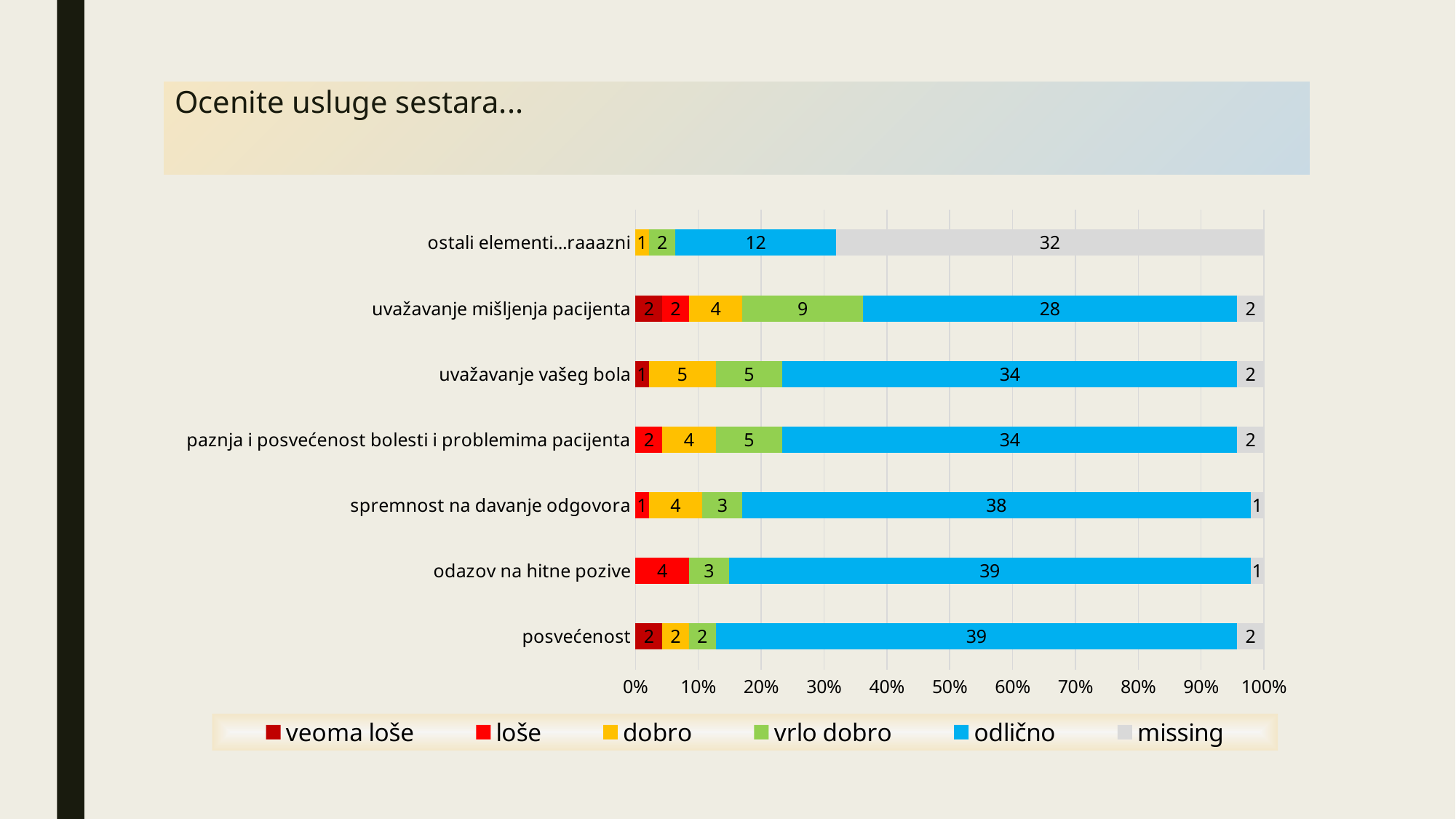
How many series does the legend list? 6 What is the 'odlično' value for 'uvažavanje mišljenja pacijenta'? 28 What kind of chart is shown on the slide? stacked bar chart Which category has the lowest 'odlično' value? ostali elementi...raaazni Which category has the highest 'missing' value? ostali elementi...raaazni What is the 'loše' value for 'odazov na hitne pozive'? 4 Which is larger: the 'dobro' value for 'uvažavanje vašeg bola' or the 'dobro' value for 'posvećenost'? uvažavanje vašeg bola What is the 'missing' value for 'ostali elementi...raaazni'? 32 What is the difference between the 'odlično' values for 'spremnost na davanje odgovora' and 'uvažavanje mišljenja pacijenta'? 10 How many categories are plotted on the chart? 7 What is the 'vrlo dobro' value for 'uvažavanje mišljenja pacijenta'? 9 What is the title of the chart? Ocenite usluge sestara...